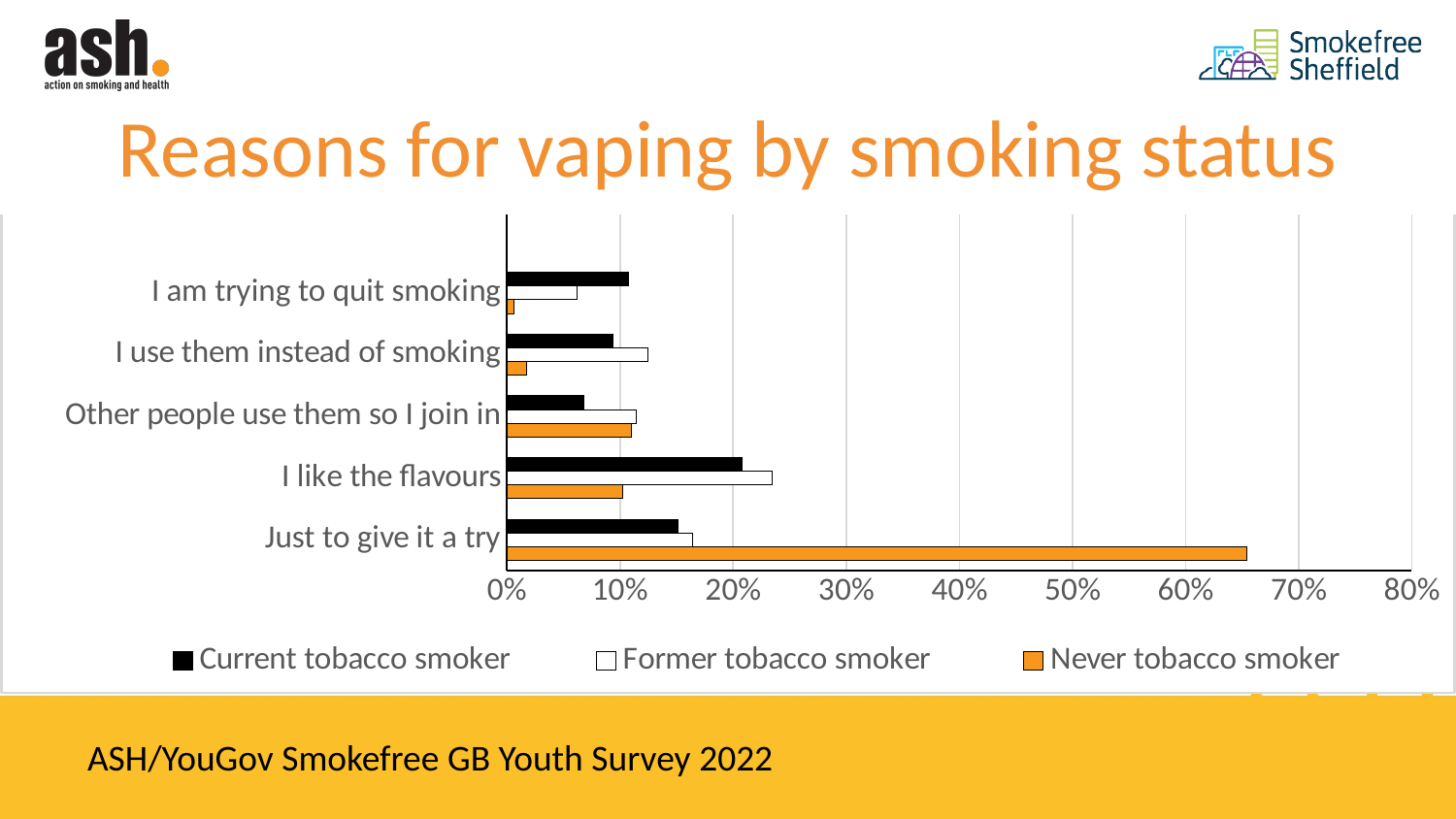
How many series does the legend list? 3 Is the value for Never tobacco smoker on 'Just to give it a try' greater or less than 60%? greater Is the value for Never tobacco smoker on 'I like the flavours' greater or less than 20%? less How many reasons (categories) are plotted on the chart? 5 For Current tobacco smokers, which reason has the highest value? I like the flavours Is the value for Former tobacco smoker on 'I use them instead of smoking' greater or less than 10%? greater For 'I am trying to quit smoking', which is larger: the Current tobacco smoker value or the Never tobacco smoker value? Current tobacco smoker What colour represents Never tobacco smoker in the legend? Orange What kind of chart is shown on the slide? Bar chart For Never tobacco smokers, which reason has the highest value? Just to give it a try For 'Other people use them so I join in', which is larger: the Current tobacco smoker value or the Former tobacco smoker value? Former tobacco smoker